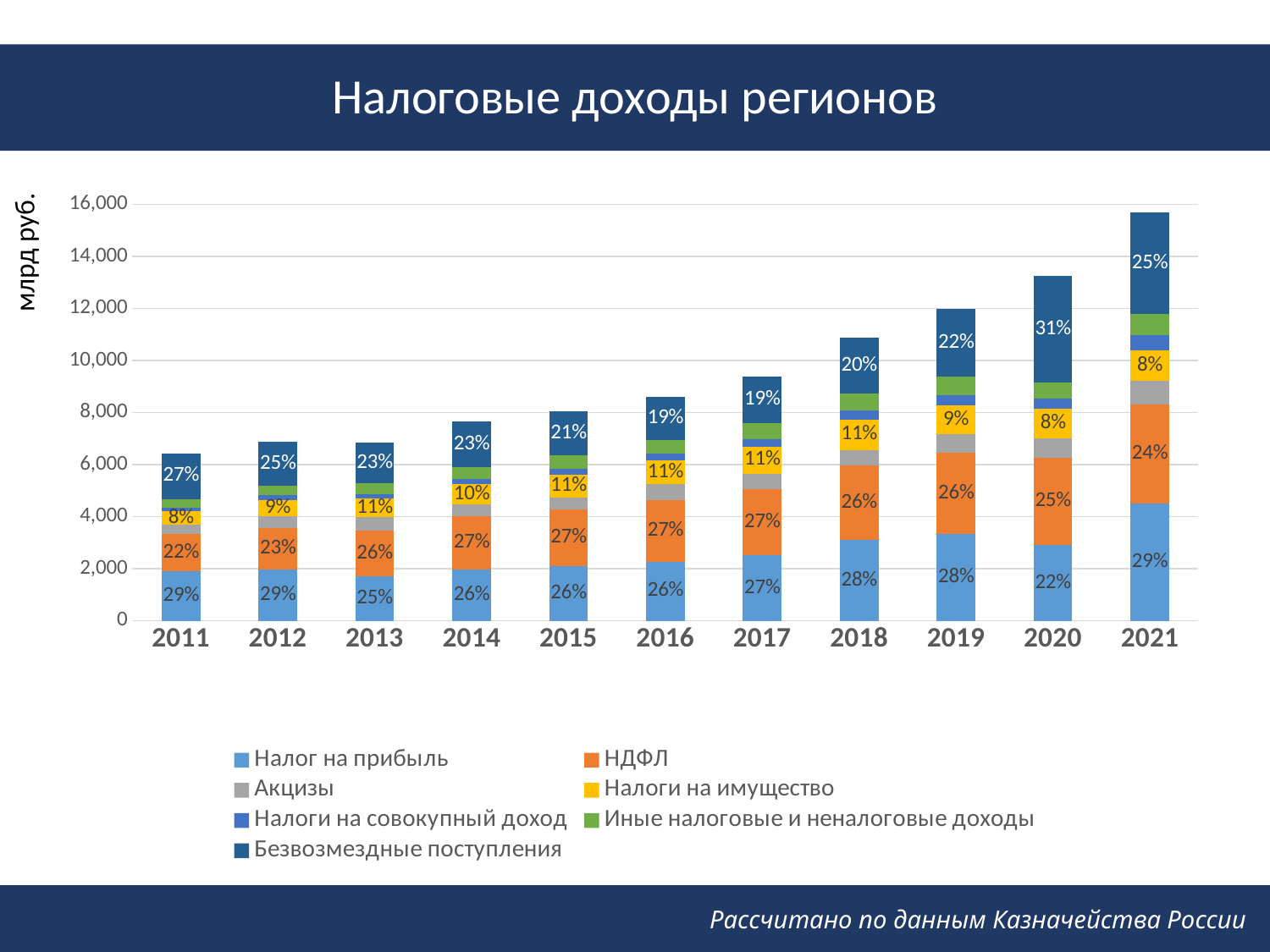
Which year has the tallest stacked bar? 2021 What is the labelled share of НДФЛ in 2013? 26% Which year has the shortest stacked bar? 2011 Which year has the larger labelled share of Безвозмездные поступления, 2020 or 2021? 2020 What is the labelled share of Налог на прибыль in 2021? 29% What type of chart is shown on the slide? Stacked bar chart By how many percentage points does the labelled share of Налог на прибыль in 2021 exceed that in 2020? 7 percentage points What is the labelled share of Налоги на имущество in 2014? 10% Is the total bar for 2021 greater or less than 14,000? greater How many years are shown on the x axis of the chart? 11 What is the labelled share of Безвозмездные поступления in 2020? 31% How many series does the legend list? 7